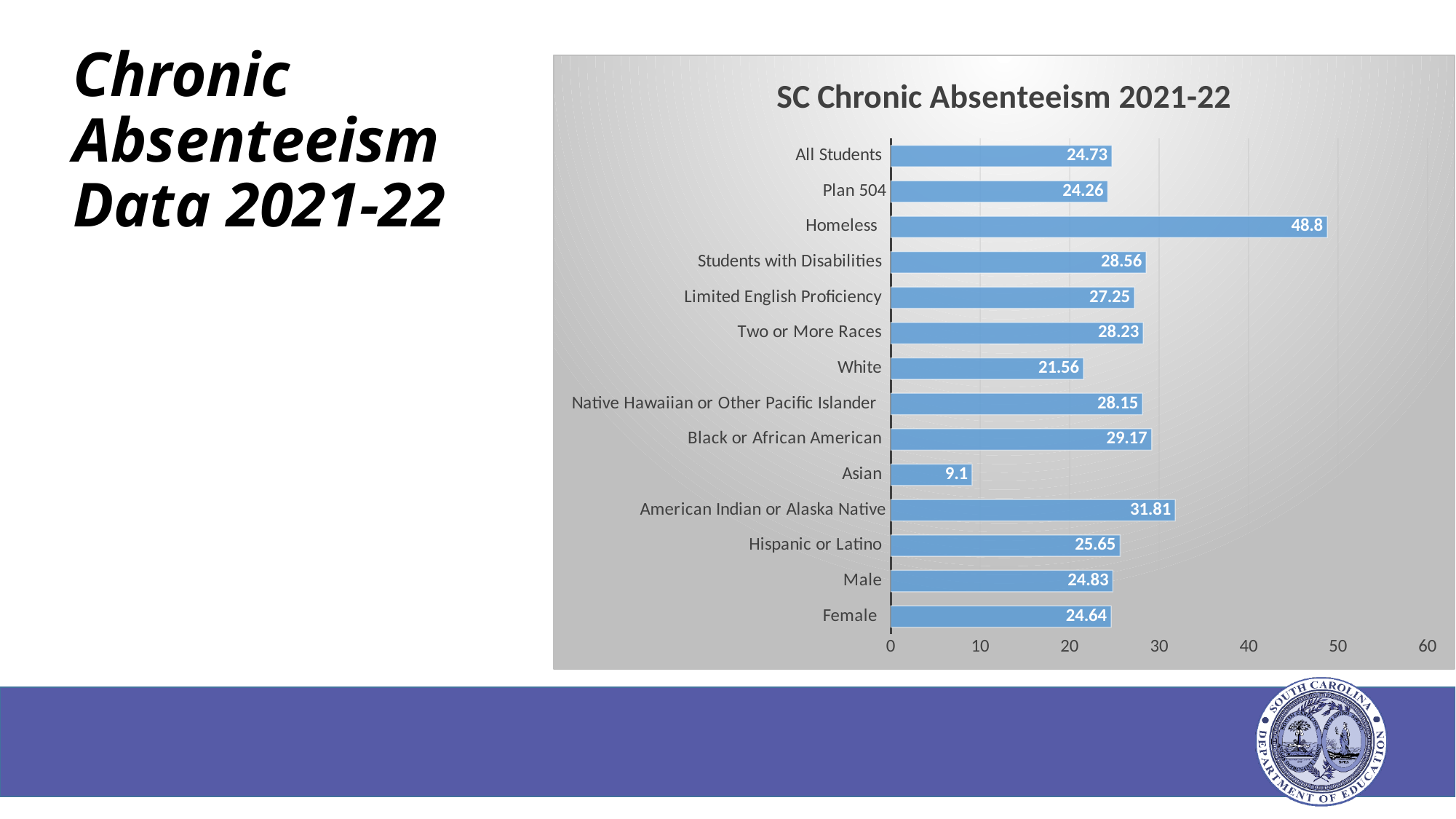
What is the value for All Students? 24.73 Which category has the highest value? Homeless What is the title of the chart? SC Chronic Absenteeism 2021-22 What is the value for Homeless in the SC Chronic Absenteeism 2021-22 chart? 48.8 Which category has the lowest value? Asian Which is larger, the value for Black or African American or the value for White? Black or African American What kind of chart is shown on the slide? Bar chart What is the value for Asian? 9.1 How many categories are shown in the chart? 14 What is the difference between the values for Male and Female? 0.19 What is the difference between the values for Homeless and Asian? 39.7 What is the value for American Indian or Alaska Native? 31.81